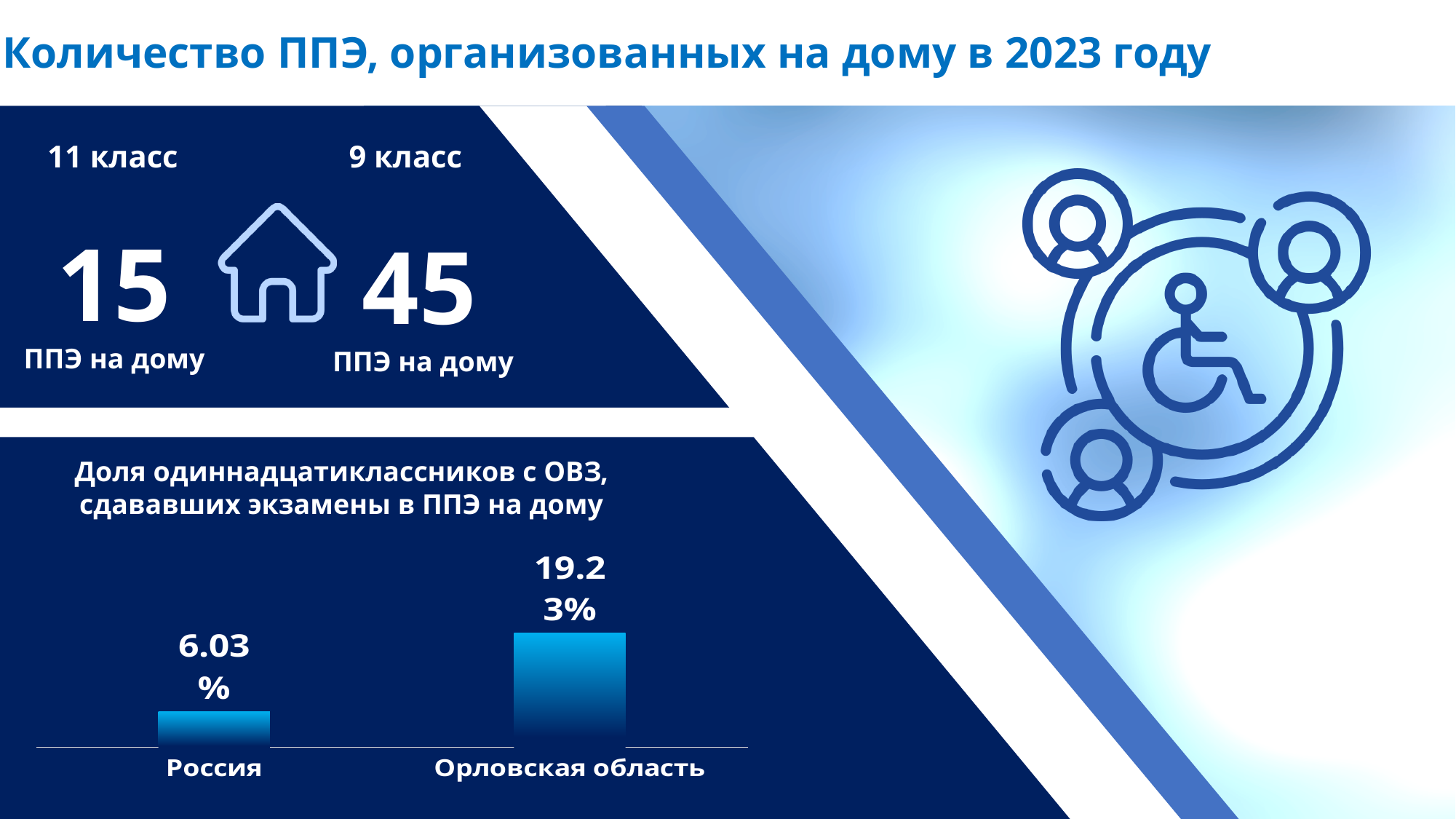
What is the difference between the values for Орловская область and Россия? 13.20% What is the value for Россия in the chart? 6.03% What is the value for Орловская область in the chart? 19.23% Do the values rise or fall from Россия to Орловская область? Rise Which category has the highest value in the chart? Орловская область How many categories are shown in the chart? 2 Which category has the lowest value in the chart? Россия Which is larger, the value for Россия or the value for Орловская область? Орловская область What kind of chart is shown on the slide? Bar chart What is the title of the chart? Доля одиннадцатиклассников с ОВЗ, сдававших экзамены в ППЭ на дому